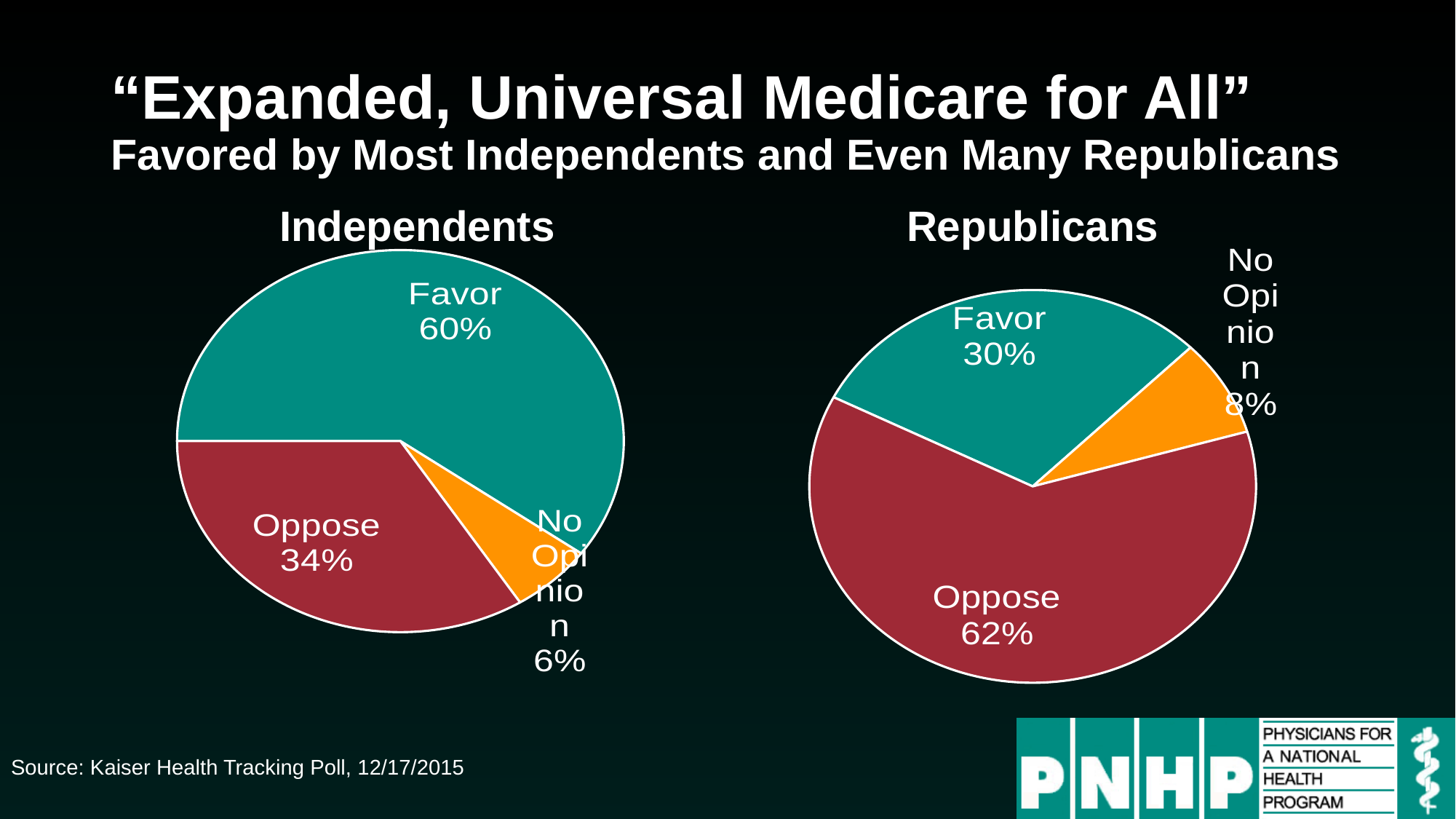
In the Independents pie chart, what percentage favor expanded, universal Medicare for All? 60% In the Republicans pie chart, what is the difference between Oppose and Favor? 32% In the Independents pie chart, what is the difference between Favor and Oppose? 26% How many slices does the Republicans pie chart have? 3 In the Republicans pie chart, which slice is the smallest? No Opinion In the Independents pie chart, which slice is the largest? Favor Is the Favor share larger in the Independents chart or the Republicans chart? Independents What type of chart is used for the Independents data? Pie chart What colour is the Oppose slice in both pie charts? Red In the Republicans pie chart, what is the share for Favor? 30% In the Independents pie chart, what is the share for No Opinion? 6% In the Republicans pie chart, what percentage oppose? 62%